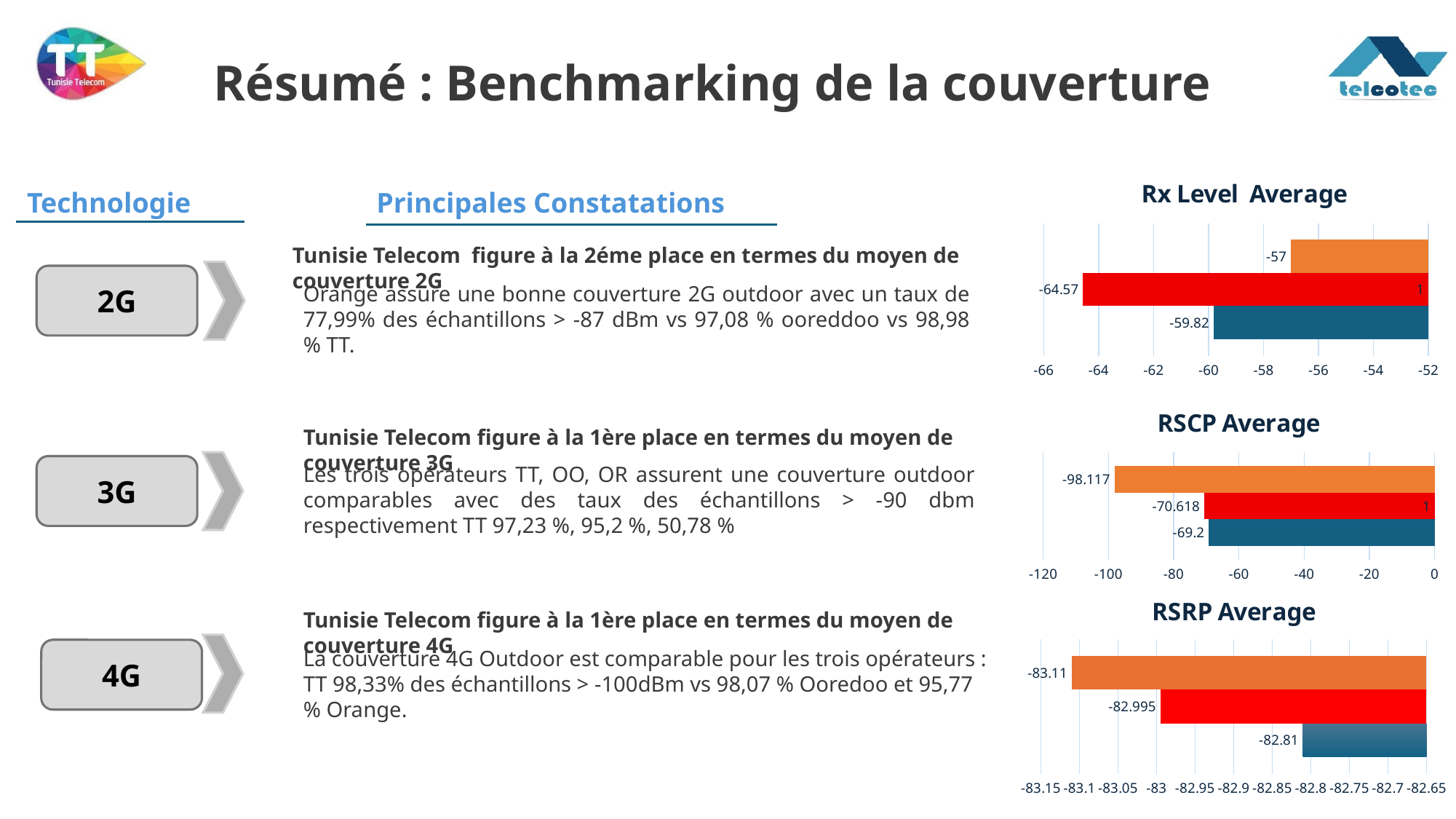
In the "RSCP Average" chart, which coloured bar has the highest value? blue In the "Rx Level Average" chart, what is the value of the orange bar? -57 In the "Rx Level Average" chart, what is the difference between the orange bar (-57) and the red bar (-64.57)? 7.57 In the "Rx Level Average" chart, what is the value of the red bar? -64.57 How many bars are plotted in the "RSRP Average" chart? 3 In the "RSRP Average" chart, what is the value of the blue bar? -82.81 What kind of chart is the "Rx Level Average" chart? bar chart In the "Rx Level Average" chart, what is the value of the blue bar? -59.82 In the "RSCP Average" chart, what is the value of the red bar? -70.618 In the "RSRP Average" chart, which is larger, the value of the red bar or the value of the orange bar? red bar In the "Rx Level Average" chart, which coloured bar has the lowest value? red In the "RSCP Average" chart, what is the value of the orange bar? -98.117